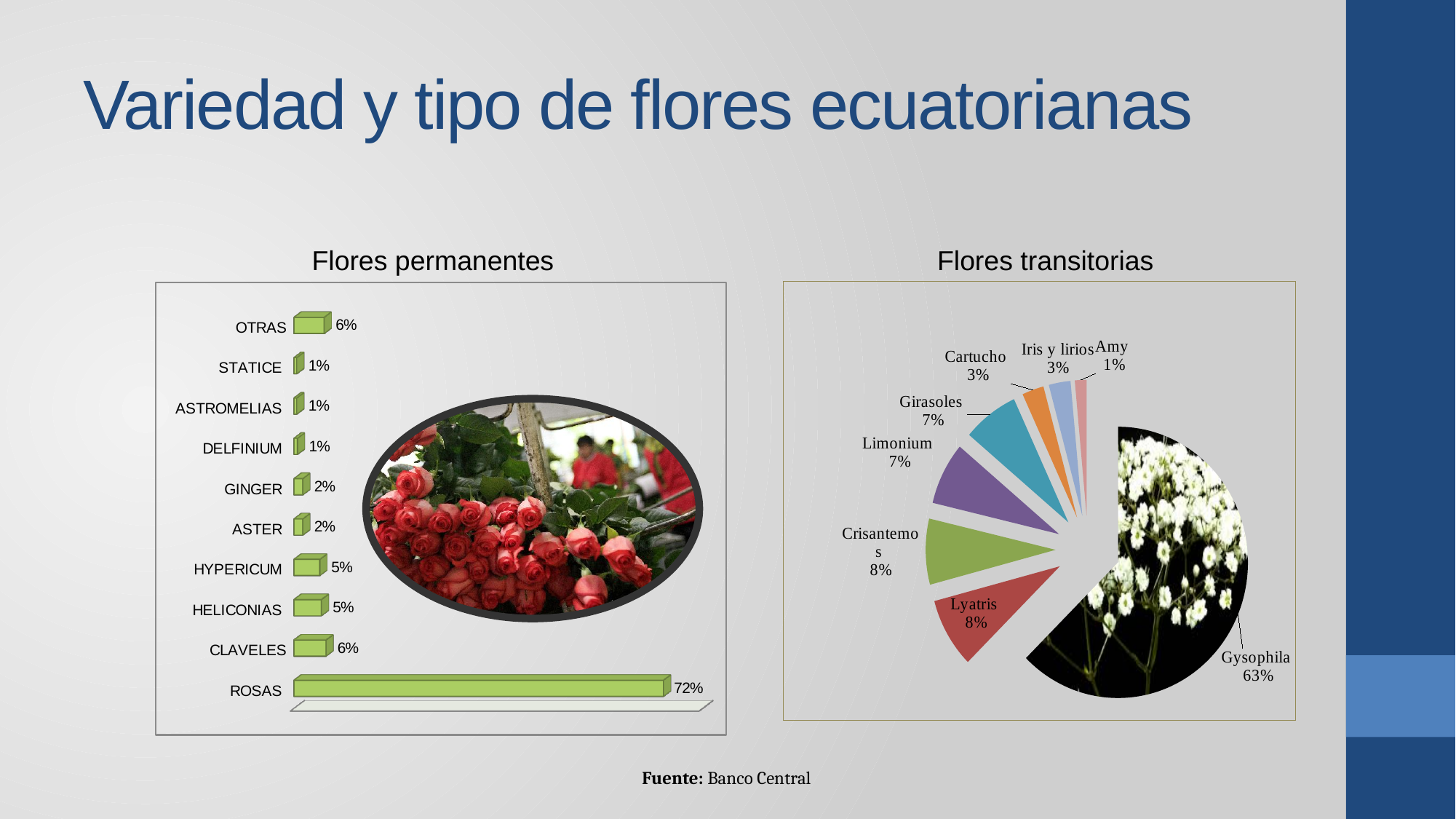
In the 'Flores permanentes' chart, which category has the highest value? ROSAS In the 'Flores permanentes' chart, what is the value for ROSAS? 72% How many categories are shown in the 'Flores permanentes' chart? 10 In the 'Flores permanentes' chart, what is the value for HYPERICUM? 5% What kind of chart is 'Flores permanentes'? Bar chart In the 'Flores transitorias' chart, which slice is the smallest? Amy What kind of chart is 'Flores transitorias'? Pie chart In the 'Flores transitorias' chart, what is the value for Limonium? 7% In the 'Flores transitorias' chart, what share does Gysophila have? 63% How many slices does the 'Flores transitorias' pie chart have? 8 In the 'Flores permanentes' chart, what is the difference between ROSAS and CLAVELES? 66% In the 'Flores permanentes' chart, which is larger, OTRAS or GINGER? OTRAS